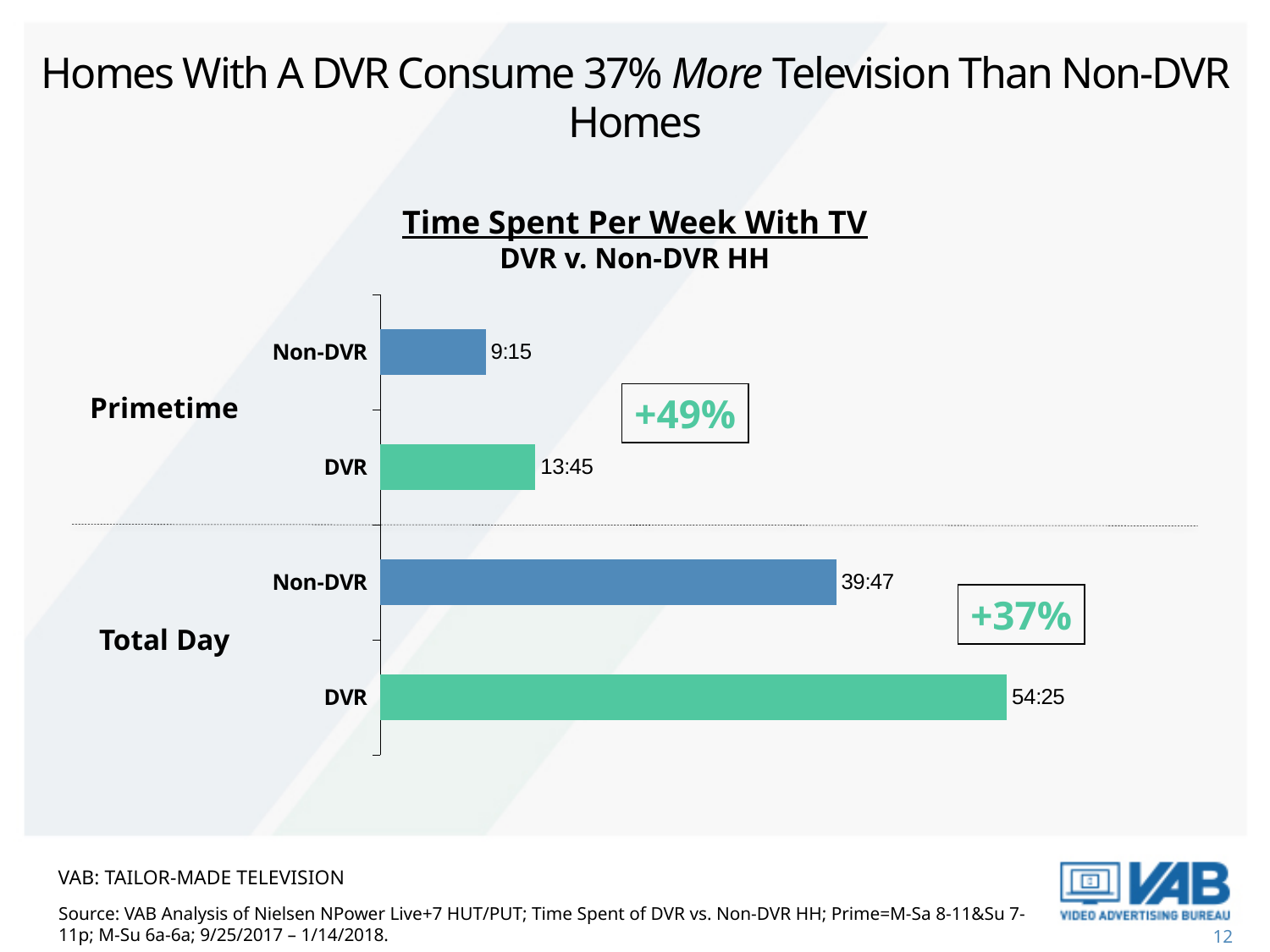
What is the difference between the DVR and Non-DVR values for Total Day? 14:38 What is the difference between the DVR and Non-DVR values in Primetime? 4:30 What is the value for DVR homes for Total Day? 54:25 Which is larger for Total Day, the DVR value or the Non-DVR value? DVR What kind of chart is shown on the slide? Bar chart What is the value for Non-DVR homes in Primetime? 9:15 What is the value for DVR homes in Primetime? 13:45 What is the value for Non-DVR homes for Total Day? 39:47 Which bar has the lowest value on the chart? Primetime Non-DVR Which bar has the highest value on the chart? Total Day DVR What percentage increase is annotated next to the Primetime bars? +49% How many bars are plotted on the chart? 4